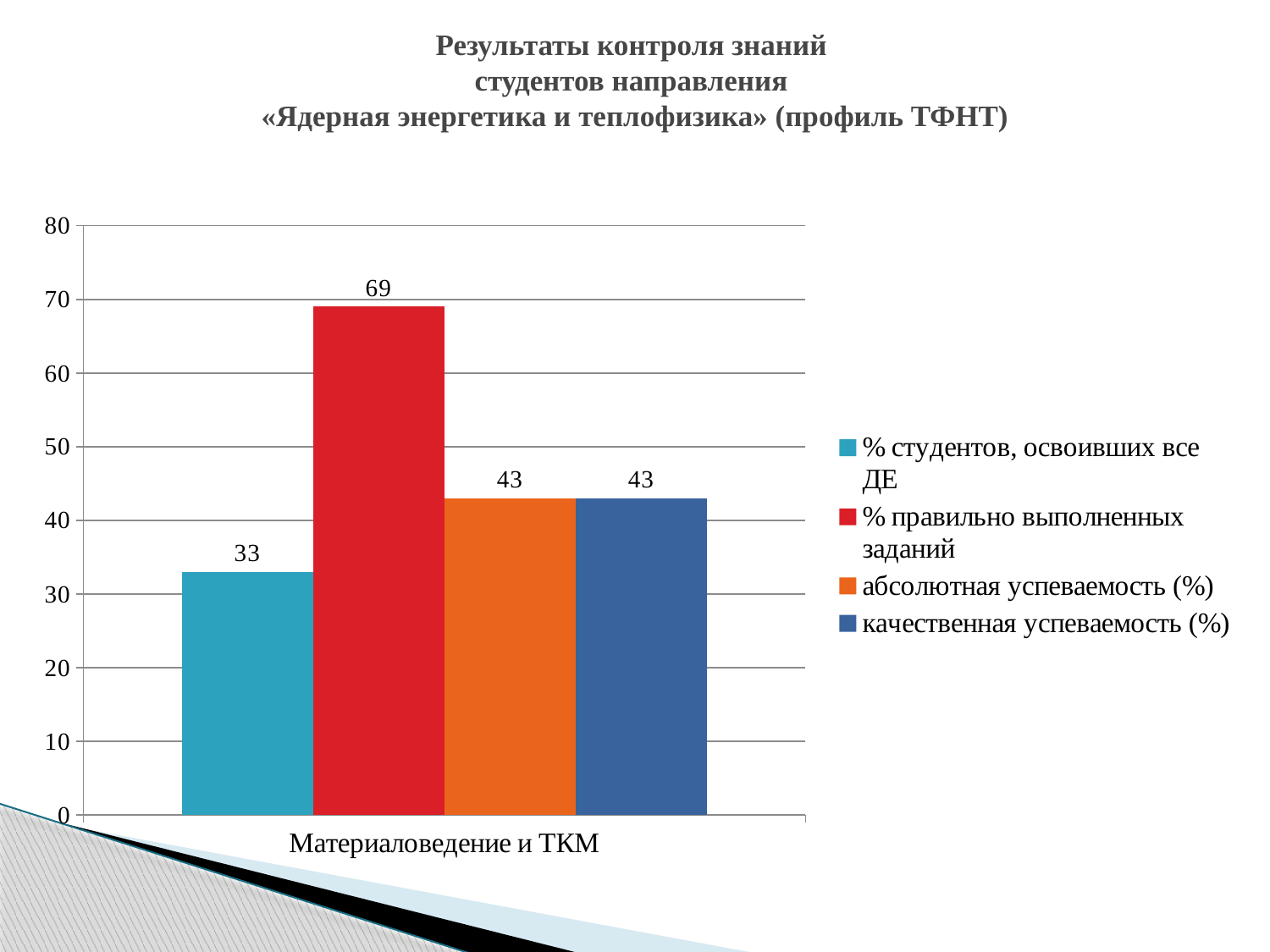
What is the value for "% студентов, освоивших все ДЕ" for Материаловедение и ТКМ? 33 What is the value for "% правильно выполненных заданий" for Материаловедение и ТКМ? 69 What is the difference between "% правильно выполненных заданий" and "% студентов, освоивших все ДЕ"? 36 Which is larger: "% студентов, освоивших все ДЕ" or "абсолютная успеваемость (%)"? абсолютная успеваемость (%) Which series has the lowest value on the chart? % студентов, освоивших все ДЕ What is the value for "качественная успеваемость (%)" for Материаловедение и ТКМ? 43 What kind of chart is shown on the slide? bar chart How many categories are shown on the x axis? 1 What is the difference between "% правильно выполненных заданий" and "абсолютная успеваемость (%)"? 26 Which series has the highest value on the chart? % правильно выполненных заданий What is the value for "абсолютная успеваемость (%)" for Материаловедение и ТКМ? 43 How many series does the legend list? 4